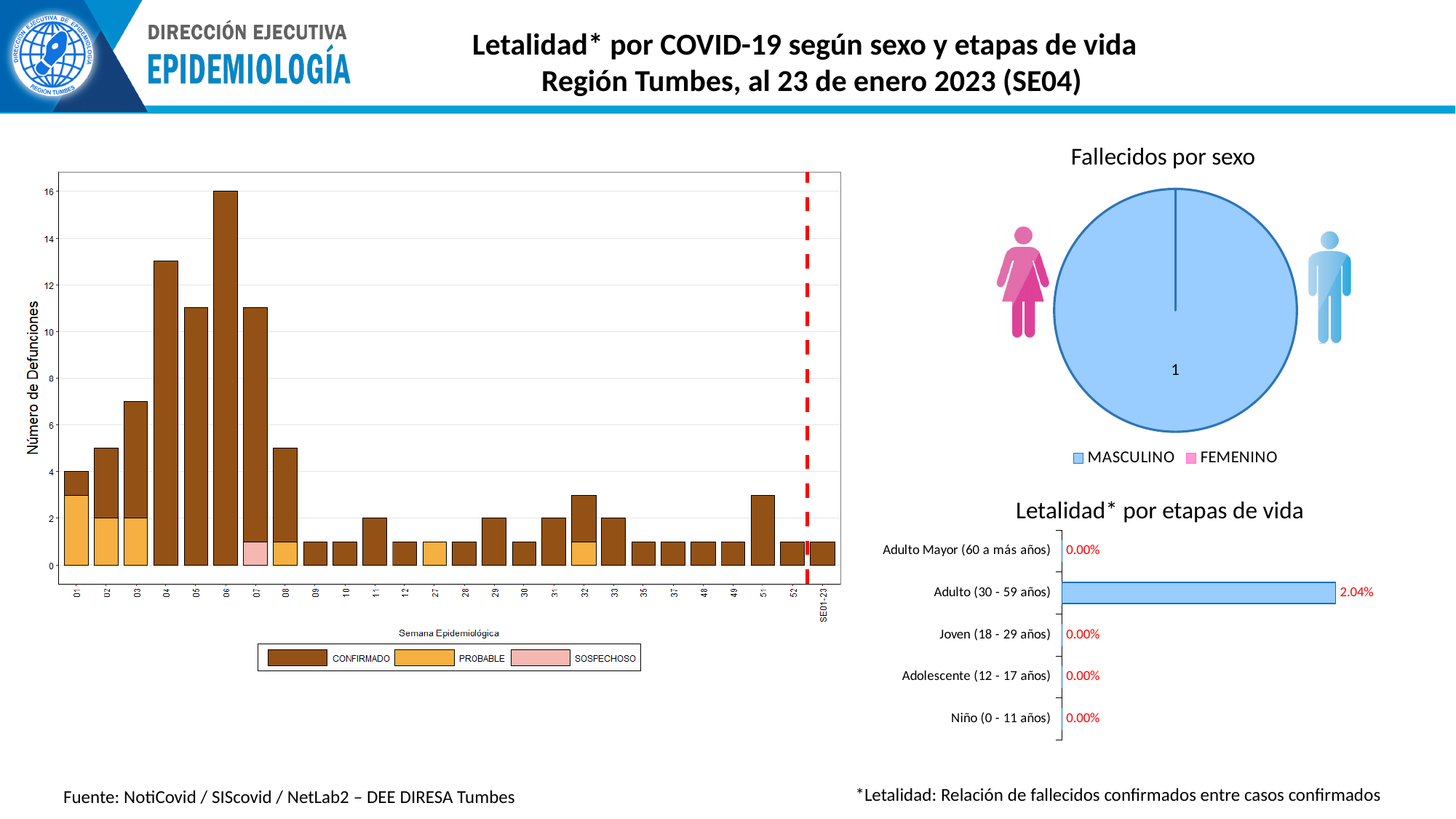
In the 'Fallecidos por sexo' chart, what value is printed on the MASCULINO slice? 1 In the chart on the left, is the value for week 03 greater or less than 8? less How many series does the legend of the chart on the left list? 3 In the chart on the left (Número de Defunciones by Semana Epidemiológica), which epidemiological week has the highest number of deaths? 06 In the 'Letalidad* por etapas de vida' chart, which life stage has the highest lethality? Adulto (30 - 59 años) In the chart on the left, is the value for week 04 greater or less than 12? greater In the chart on the left, which is larger, the bar for week 05 or the bar for week 08? week 05 What kind of chart is the chart on the left (Número de Defunciones)? stacked bar chart What kind of chart is 'Fallecidos por sexo'? pie chart In the 'Letalidad* por etapas de vida' chart, what is the value for Adulto (30 - 59 años)? 2.04% In the chart on the left, what is the number of deaths for week 06? 16 How many categories are shown in the 'Letalidad* por etapas de vida' chart? 5